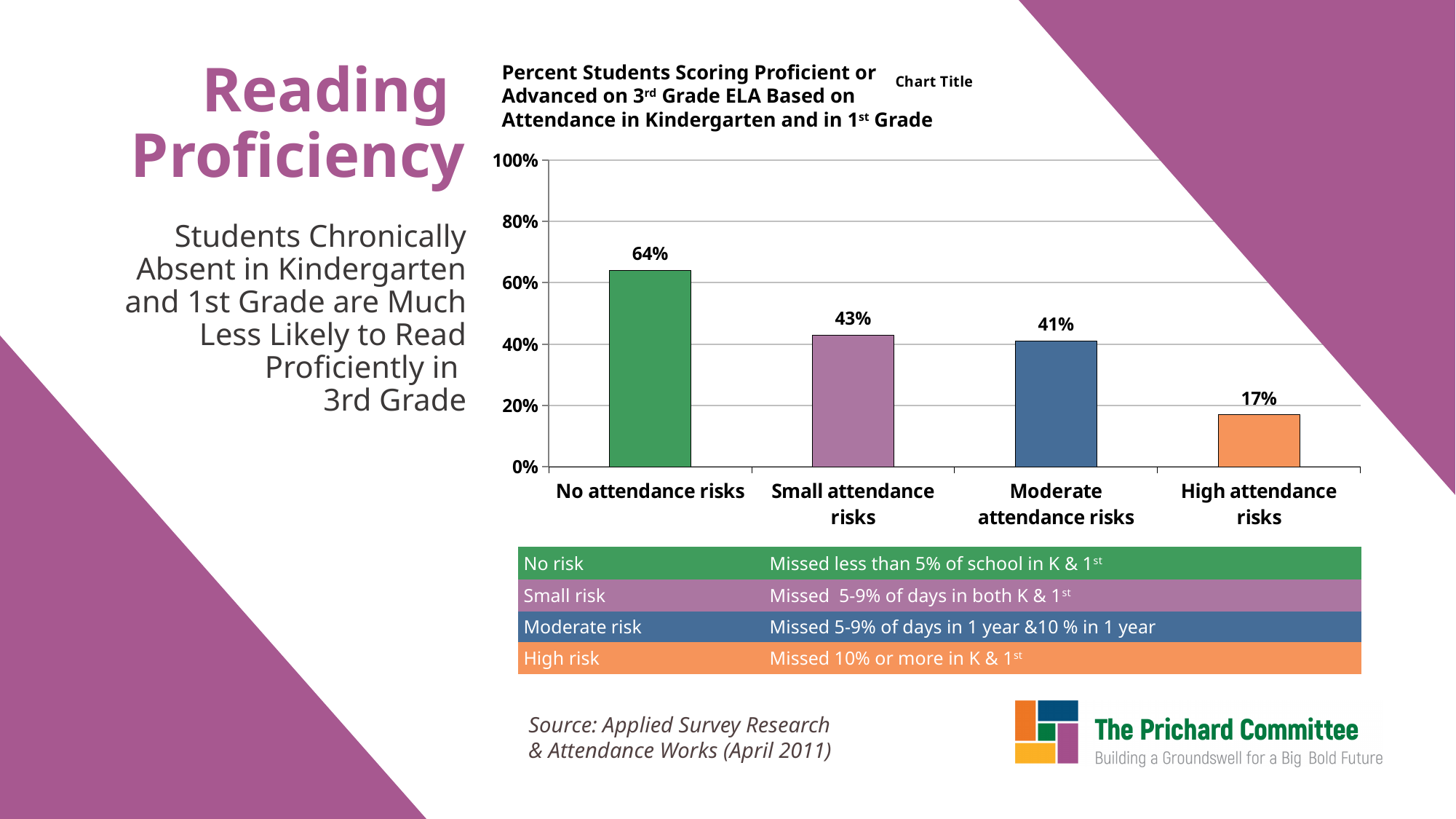
What kind of chart is shown? Bar chart How many categories are shown on the x axis? 4 What is the value for Small attendance risks? 43% What is the difference between the values for No attendance risks and High attendance risks? 47% Which category has the lowest value? High attendance risks Which category has the highest value? No attendance risks What is the value for No attendance risks? 64% What is the difference between the values for Small attendance risks and Moderate attendance risks? 2% What is the value for High attendance risks? 17% What is the value for Moderate attendance risks? 41% Do the values rise or fall from left to right along the x axis? Fall Which is larger, the value for No attendance risks or the value for Small attendance risks? No attendance risks